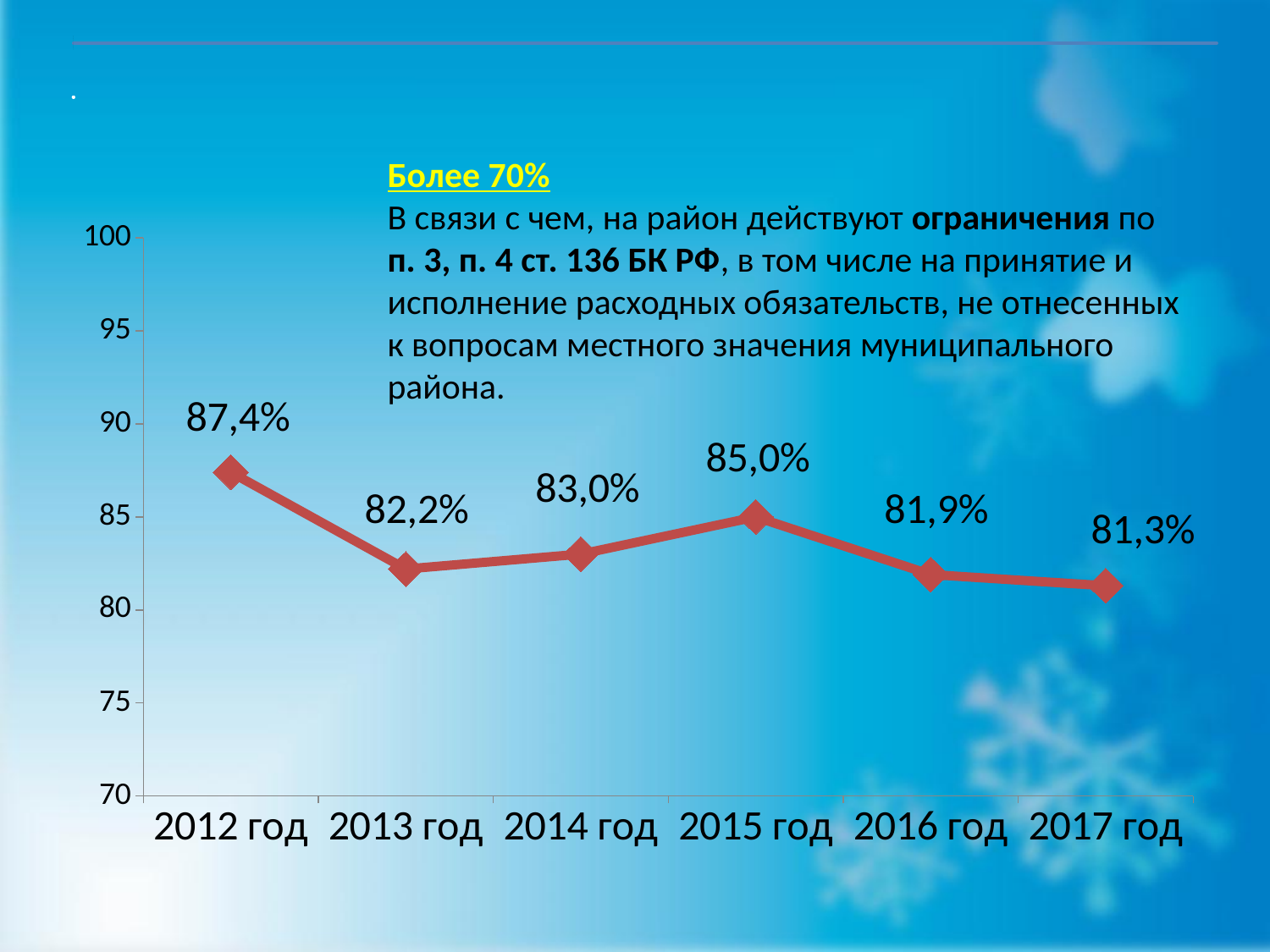
How many years are plotted on the chart? 6 Which is larger, the value for 2014 год or the value for 2016 год? 2014 год What is the value for 2012 год? 87,4% What is the value for 2015 год? 85,0% What is the difference between the values for 2012 год and 2013 год? 5,2% What is the lowest value shown on the vertical axis? 70 Do the values generally rise or fall from 2012 год to 2017 год? fall Is the value for 2013 год greater or less than 85? less Which year has the lowest value? 2017 год What is the value for 2017 год? 81,3% Which year has the highest value? 2012 год What kind of chart is shown on the slide? line chart